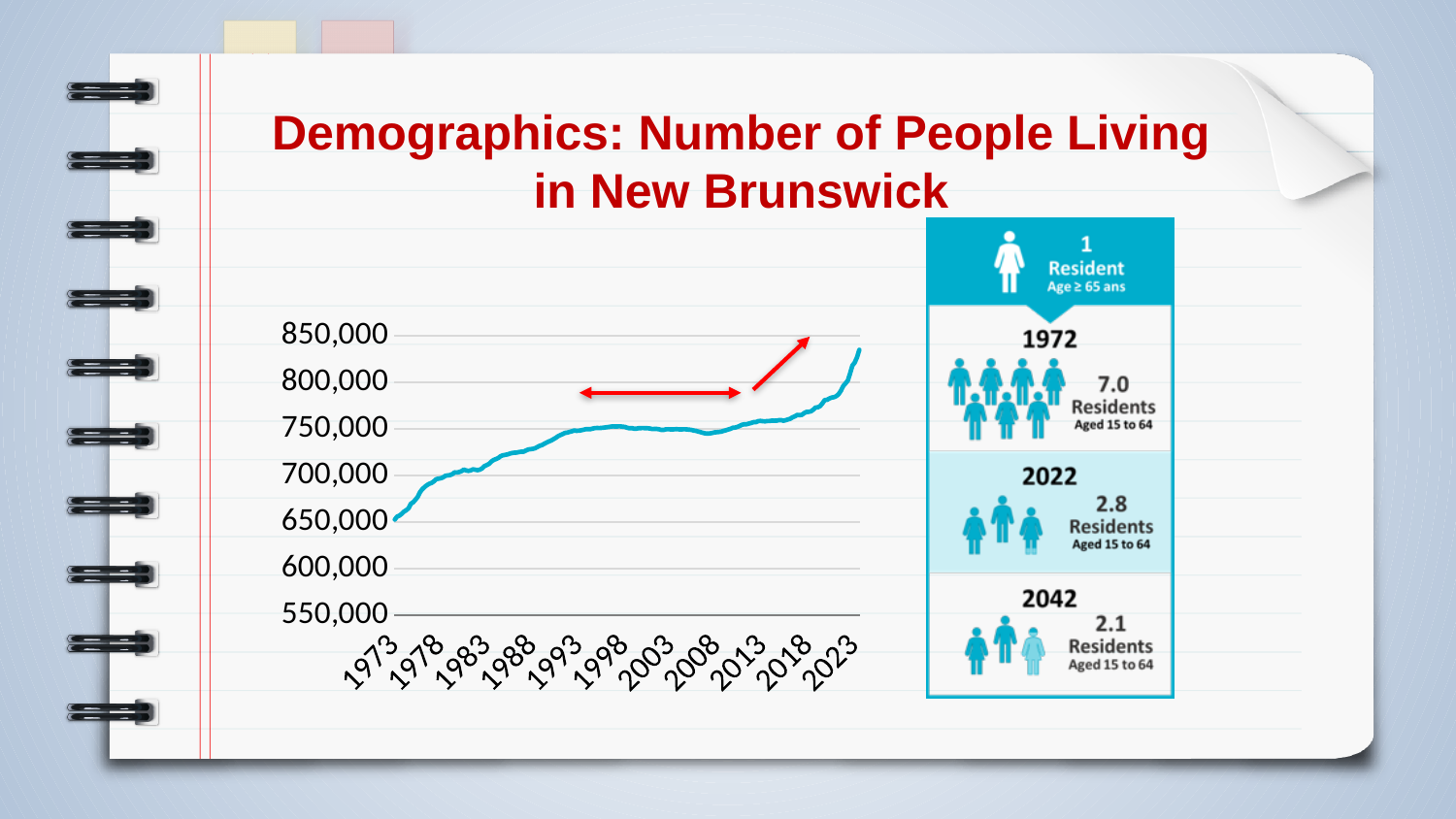
Is the value for 2023 greater or less than 800,000? greater Which is larger, the value for 2023 or the value for 1993? 2023 What kind of chart is shown on the slide? Line chart Does the number of people living in New Brunswick generally rise or fall from 1973 to 2023? Rise Is the value for 1973 greater or less than 700,000? less What is the title of the slide containing the chart? Demographics: Number of People Living in New Brunswick Is the value for 1983 greater or less than 650,000? greater Which year labelled on the x axis has the lowest population value? 1973 Which year labelled on the x axis has the highest population value? 2023 How many year labels are shown on the x axis? 11